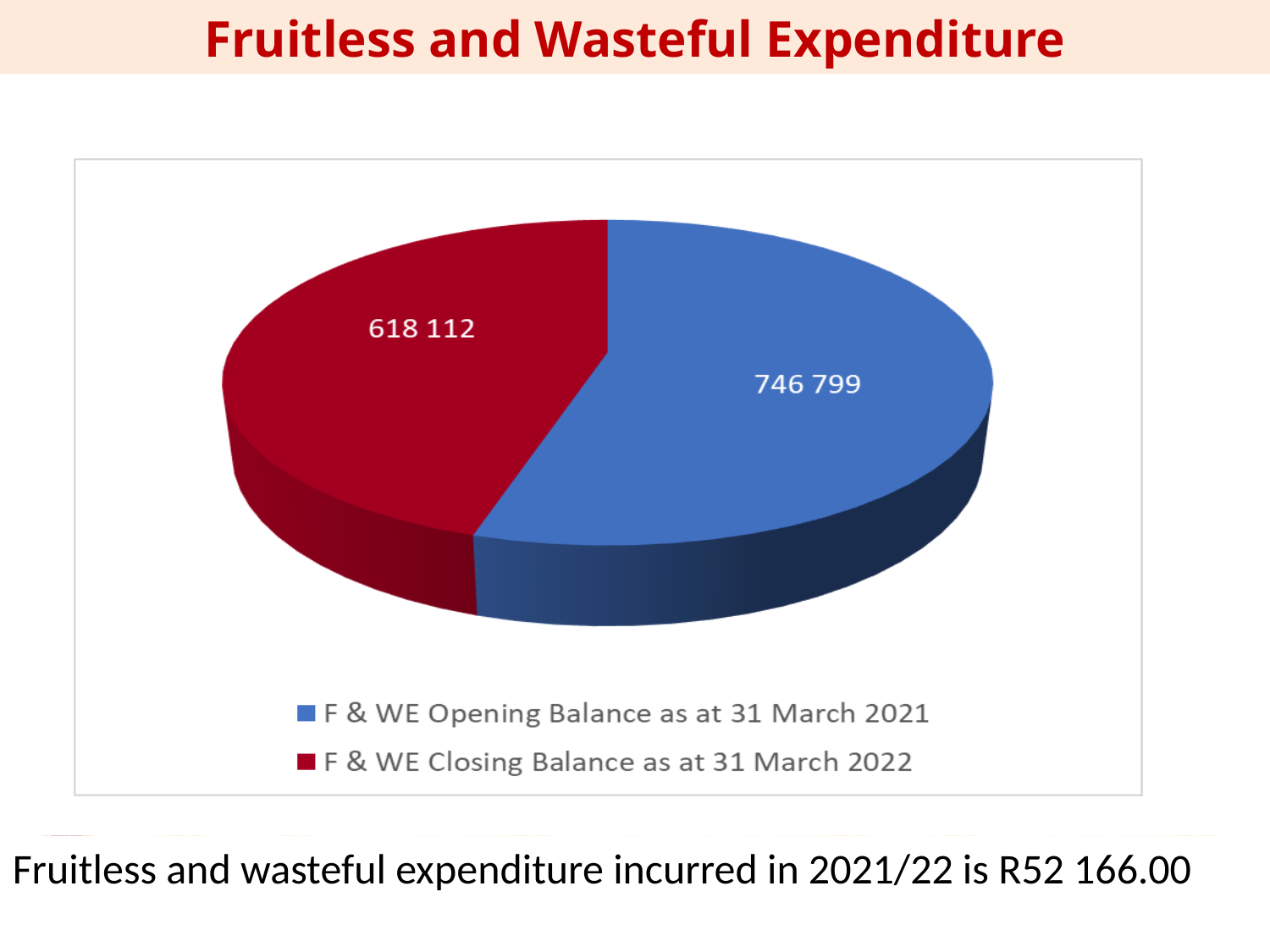
What is the difference between the opening balance as at 31 March 2021 and the closing balance as at 31 March 2022? 128 687 What is the total of the two values shown in the pie chart? 1 364 911 Which slice of the pie is the largest? F & WE Opening Balance as at 31 March 2021 How many slices does the pie chart have? 2 Which slice of the pie is the smallest? F & WE Closing Balance as at 31 March 2022 How many entries does the legend list? 2 What is the title of the slide containing the pie chart? Fruitless and Wasteful Expenditure What colour is the slice for F & WE Closing Balance as at 31 March 2022? Red What is the value for F & WE Closing Balance as at 31 March 2022? 618 112 What kind of chart is shown on the slide? Pie chart Which is larger, the opening balance as at 31 March 2021 or the closing balance as at 31 March 2022? Opening balance as at 31 March 2021 What is the value for F & WE Opening Balance as at 31 March 2021? 746 799